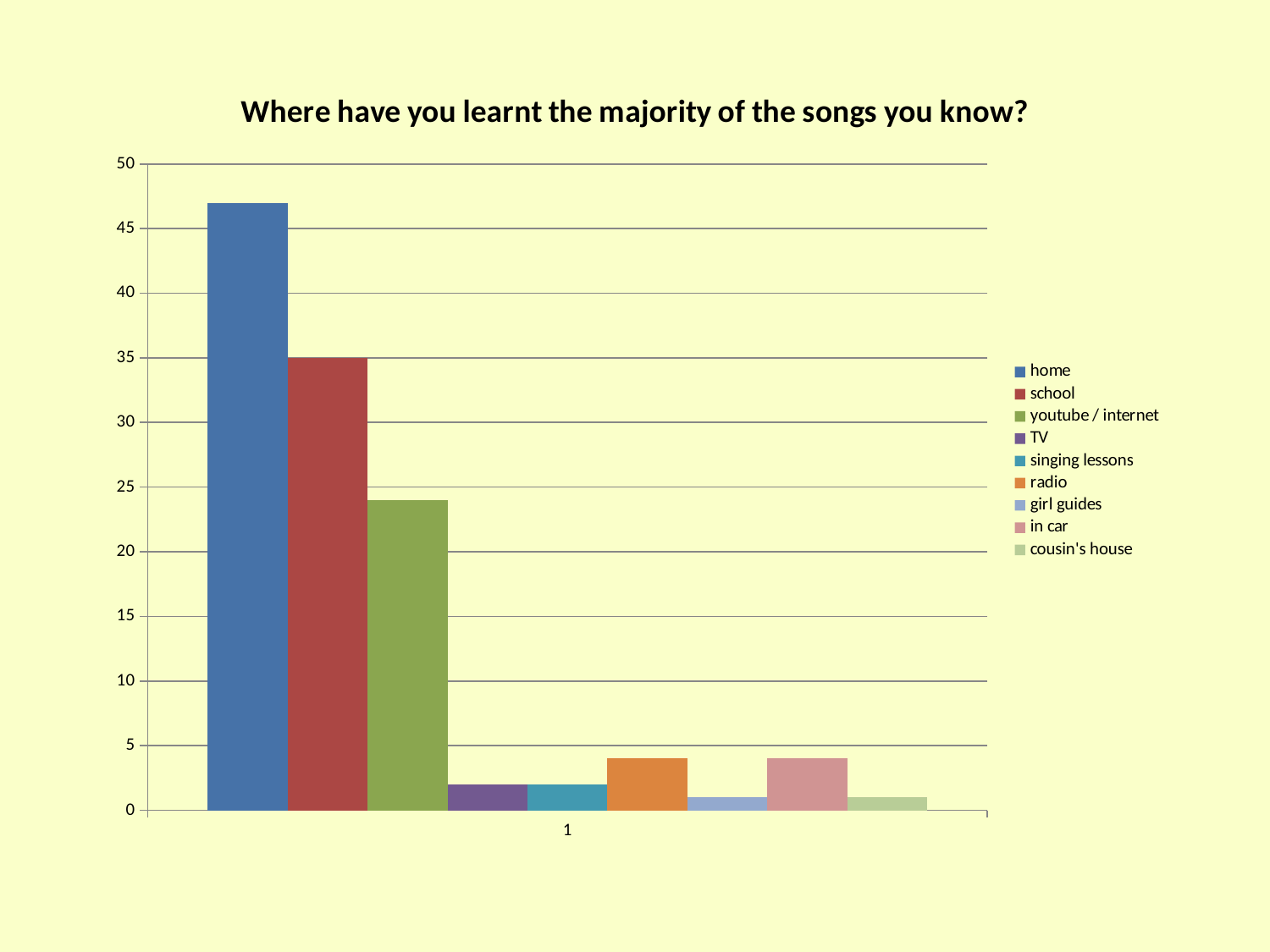
How many series does the legend list? 9 Is the value for home greater or less than 45? greater Which is larger, the value for in car or the value for girl guides? in car What is the title of the chart? Where have you learnt the majority of the songs you know? Is the value for radio greater or less than 5? less Which series has the highest value? home Which is larger, the value for home or the value for school? home What type of chart is shown on the slide? bar chart Is the value for youtube / internet greater or less than 25? less Which is larger, the value for youtube / internet or the value for radio? youtube / internet What is the value for school? 35